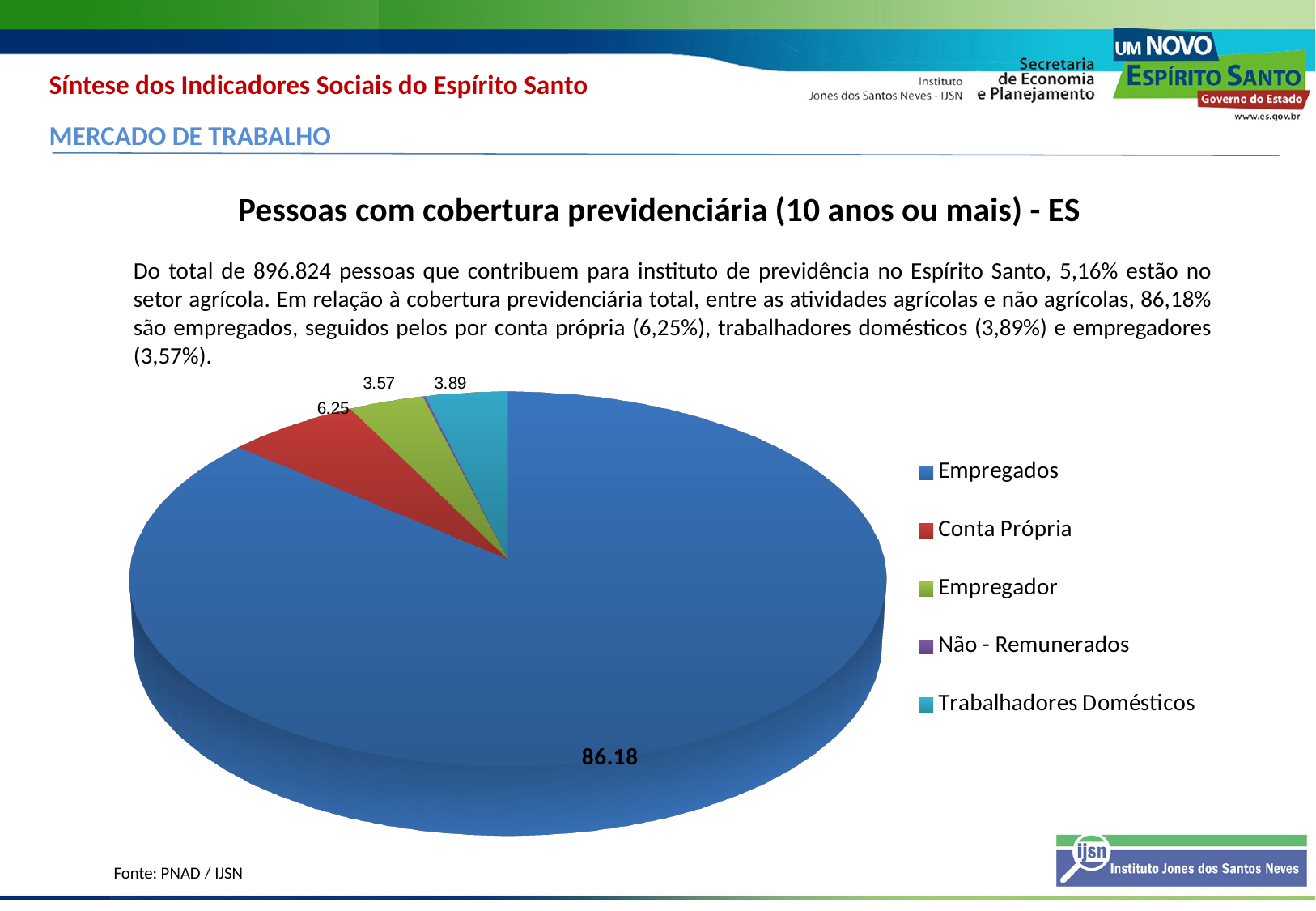
What colour is the Empregados slice in the pie chart? Blue What source is cited below the chart? PNAD / IJSN Which is larger, the slice for Empregador or the slice for Trabalhadores Domésticos? Trabalhadores Domésticos What value is shown for Trabalhadores Domésticos in the pie chart? 3.89 Which category has the largest slice of the pie chart? Empregados What value is shown for Empregador in the pie chart? 3.57 What value is shown for Empregados in the pie chart? 86.18 What value is shown for Conta Própria in the pie chart? 6.25 How many categories does the legend of the pie chart list? 5 What kind of chart is shown on the slide? Pie chart What is the difference between the values for Trabalhadores Domésticos and Empregador? 0.32 What is the difference between the values for Empregados and Conta Própria? 79.93